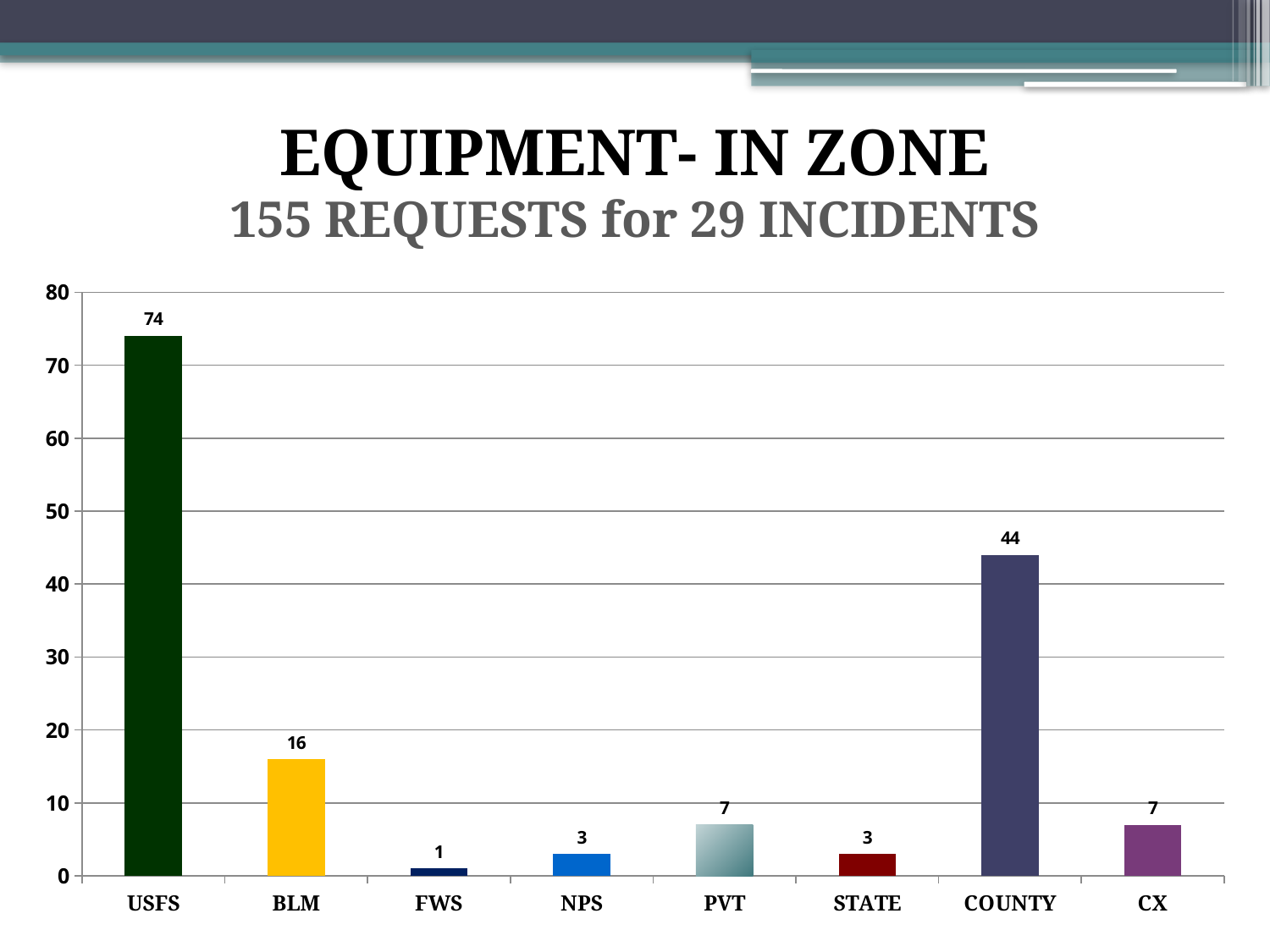
Which category has the lowest value? FWS What is the value for USFS? 74 What is the difference between the values for USFS and COUNTY? 30 What kind of chart is shown on the slide? Bar chart How many categories are shown on the x axis? 8 What is the value for FWS? 1 What is the difference between the values for BLM and NPS? 13 Which is larger, the value for BLM or the value for PVT? BLM What is the value for COUNTY? 44 Which category has the highest value? USFS What is the title of the slide? EQUIPMENT- IN ZONE What is the value for BLM? 16